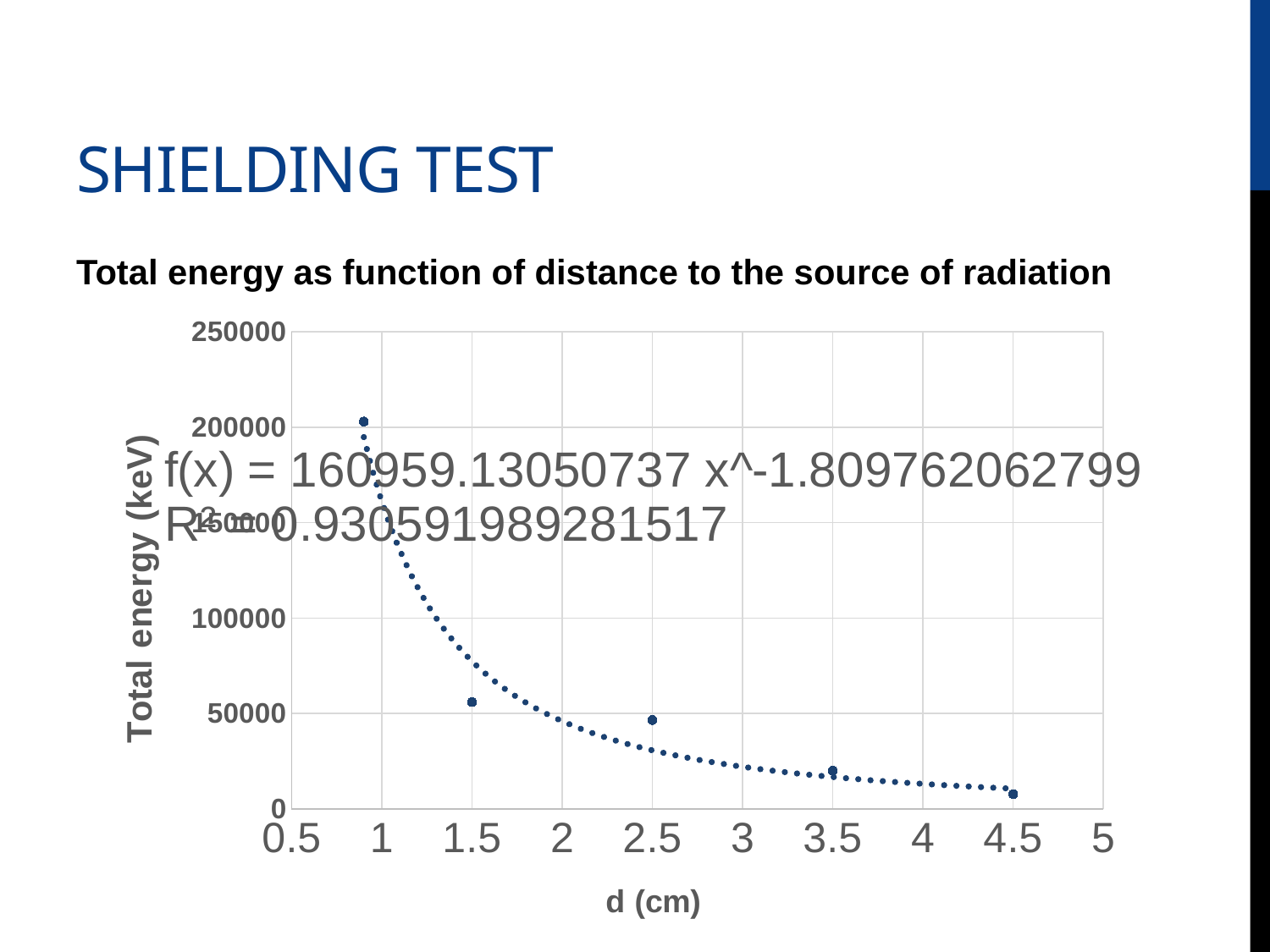
Do the plotted total energy values rise or fall as the distance d increases? Fall Is the total energy value at d = 1.5 cm greater or less than 100000? less Is the highest total energy value found at the smallest or the largest distance d? Smallest What R² value is shown for the trendline on the chart? 0.930591989281517 What kind of chart is shown on the slide? Scatter chart At which distance d is the lowest total energy value plotted? 4.5 cm Which has the larger total energy value: the point at d = 1.5 cm or the point at d = 4.5 cm? d = 1.5 cm Is the total energy value of the leftmost data point greater or less than 150000? greater How many data points are plotted in the chart? 5 What is the label of the x axis? d (cm) Is the total energy value at d = 4.5 cm greater or less than 50000? less